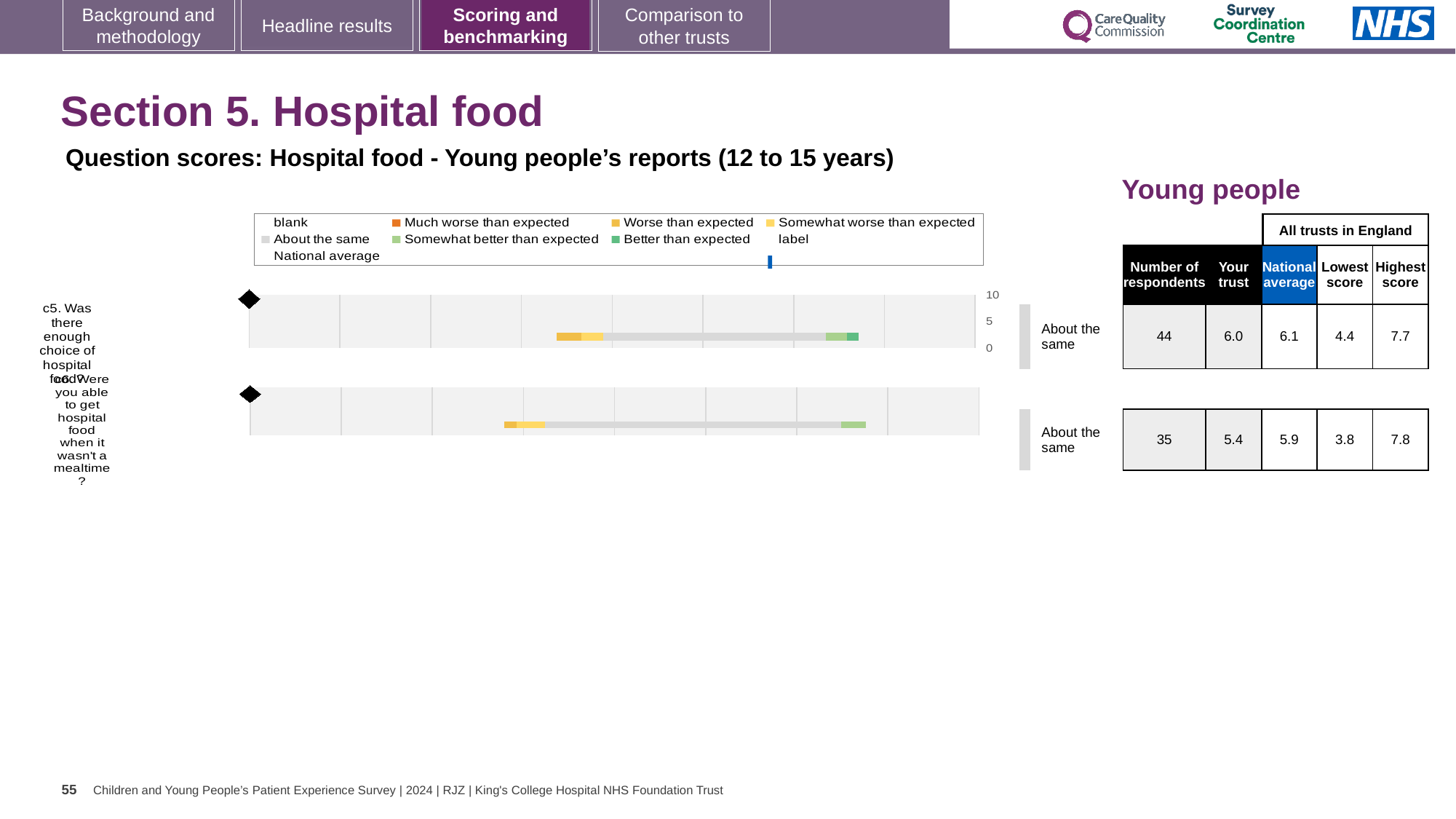
Is the 'Your trust' score for question c6 higher or lower than the national average? Lower What is the difference between the highest score and the lowest score for question c5? 3.3 How many respondents answered question c5 (Was there enough choice of hospital food?)? 44 What is the 'Your trust' score for question c5? 6.0 What is the highest score among all trusts in England for question c6? 7.8 How many questions are plotted in the hospital food chart? 2 What is the maximum value shown on the chart's score axis? 10 Which question had more respondents, c5 or c6? c5 What kind of chart is used to show the question scores for hospital food? Bar chart Which question has the lower 'Your trust' score, c5 or c6? c6 What is the national average score for question c6 (Were you able to get hospital food when it wasn't a mealtime?)? 5.9 Which legend entry corresponds to the grey segment of the bars? About the same